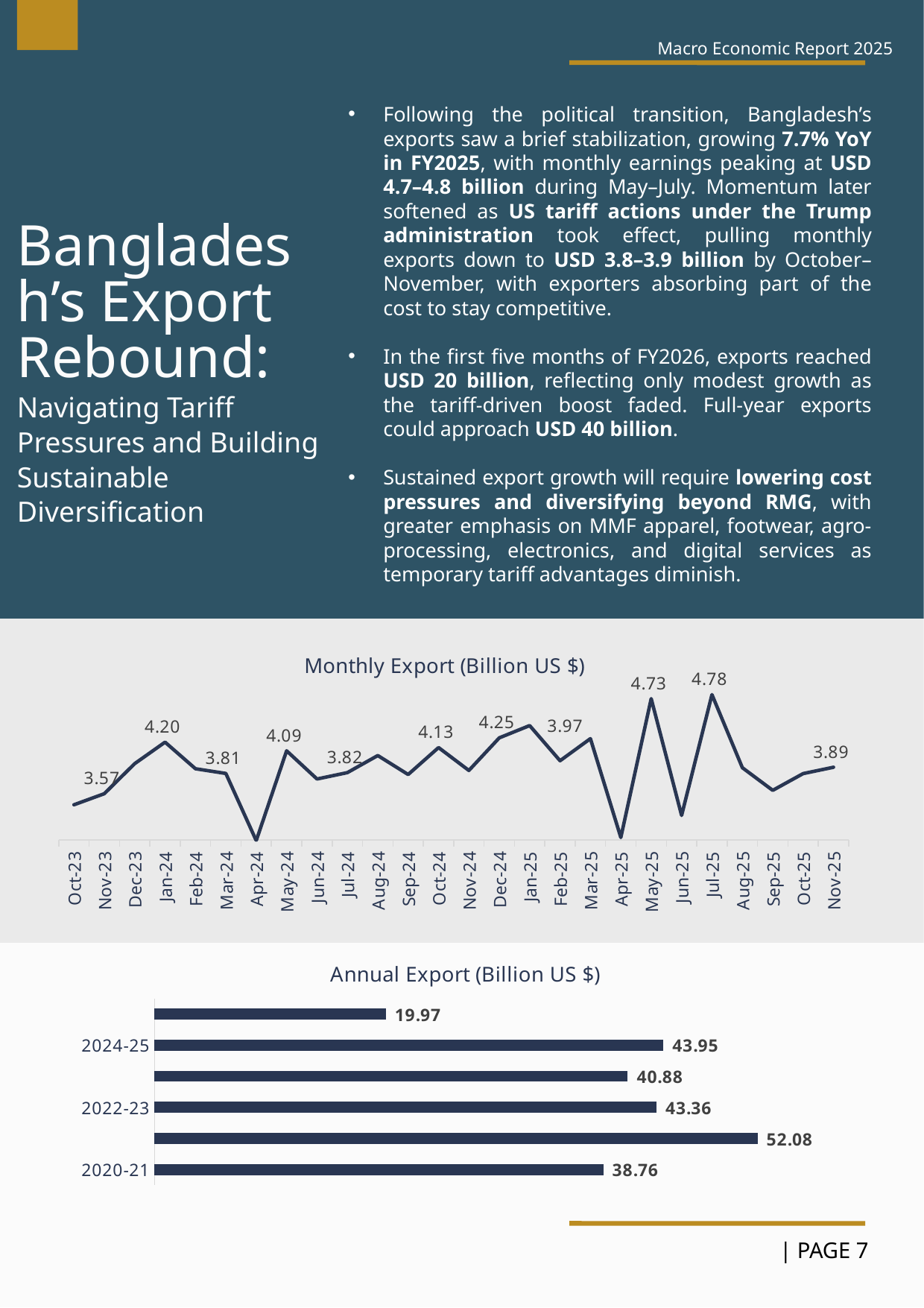
In the Monthly Export (Billion US $) chart, what is the value for Nov-25? 3.89 What kind of chart is the Monthly Export (Billion US $) chart? line chart In the Annual Export (Billion US $) chart, what is the value for 2020-21? 38.76 In the Monthly Export (Billion US $) chart, which month has the highest value? Jul-25 In the Monthly Export (Billion US $) chart, what is the difference between the Jul-25 and May-25 values? 0.05 In the Annual Export (Billion US $) chart, which is larger, the value for 2022-23 or the value for 2020-21? 2022-23 In the Annual Export (Billion US $) chart, what is the value for 2024-25? 43.95 In the Annual Export (Billion US $) chart, what is the difference between the 2022-23 and 2020-21 values? 4.60 In the Monthly Export (Billion US $) chart, what is the value for Jul-25? 4.78 In the Monthly Export (Billion US $) chart, what is the value for May-25? 4.73 What kind of chart is the Annual Export (Billion US $) chart? bar chart How many bars are shown in the Annual Export (Billion US $) chart? 6